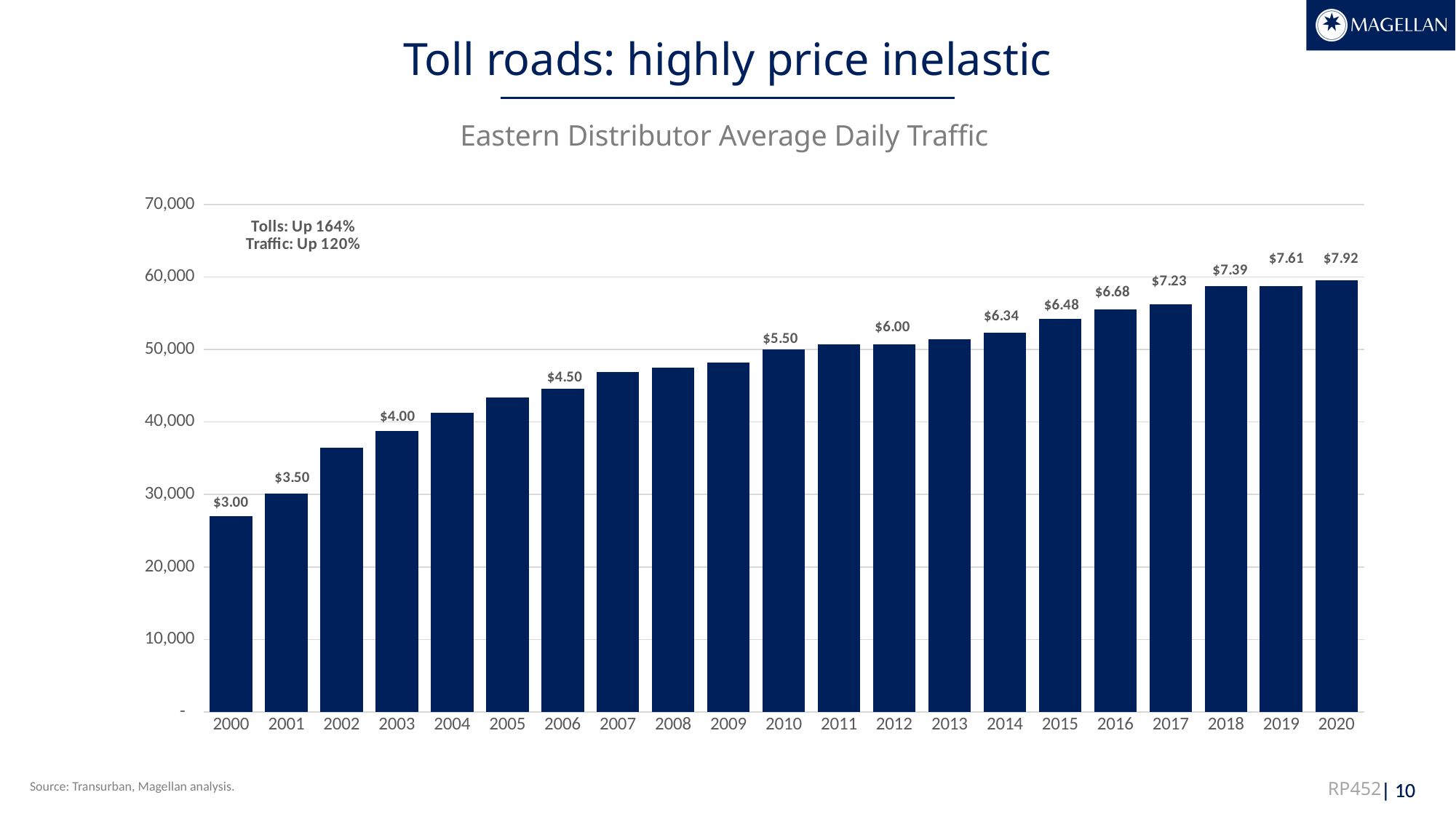
What toll is labelled above the 2017 bar? $7.23 Do the traffic values generally rise or fall from 2000 to 2020? Rise Is the average daily traffic for 2000 greater or less than 30,000? less According to the annotation on the chart, by what percentage are tolls up? 164% Which year has the lowest average daily traffic? 2000 Which year has the highest average daily traffic? 2020 What kind of chart is shown on the slide? Bar chart What toll is labelled above the 2010 bar? $5.50 How many years are plotted on the x axis of the chart? 21 Is the average daily traffic for 2008 greater or less than 50,000? less Is the average daily traffic for 2005 greater or less than 40,000? greater What is the difference between the toll labelled for 2020 and the toll labelled for 2000? $4.92